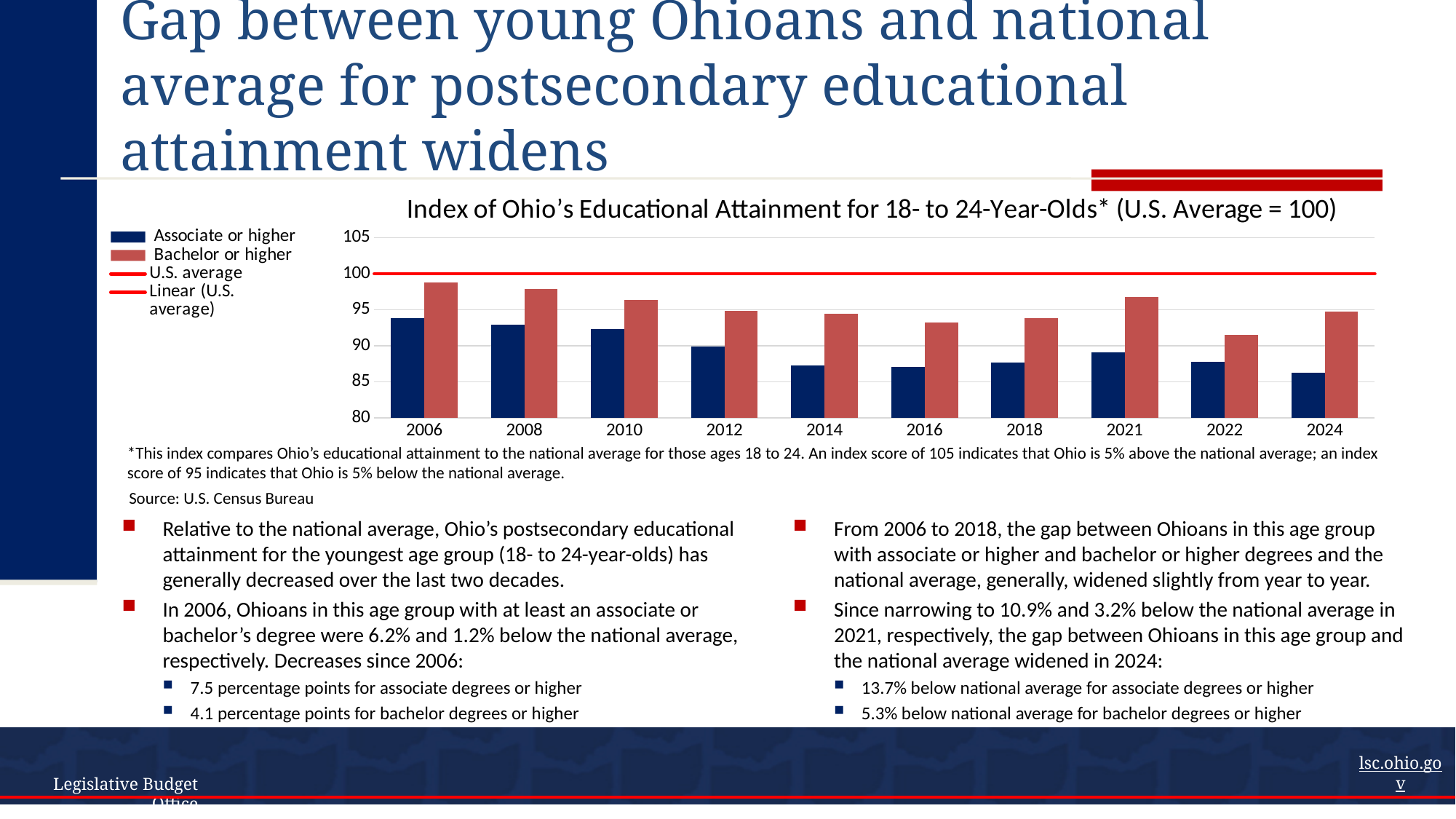
Does the Associate or higher series generally rise or fall from 2006 to 2024? Fall What kind of chart is shown on the slide? Bar chart Is the value for Bachelor or higher in 2021 greater or less than 95? greater At what index value is the U.S. average line drawn on the chart? 100 Which year has the lowest value for Associate or higher? 2024 Which year has the lowest value for Bachelor or higher? 2022 Is the value for Associate or higher in 2006 greater or less than 90? greater How many entries does the chart's legend list? 4 In 2006, which series has the larger value, Associate or higher or Bachelor or higher? Bachelor or higher Which year has the highest value for Bachelor or higher? 2006 Is the value for Associate or higher in 2014 greater or less than 90? less How many years are shown along the x axis of the chart? 10